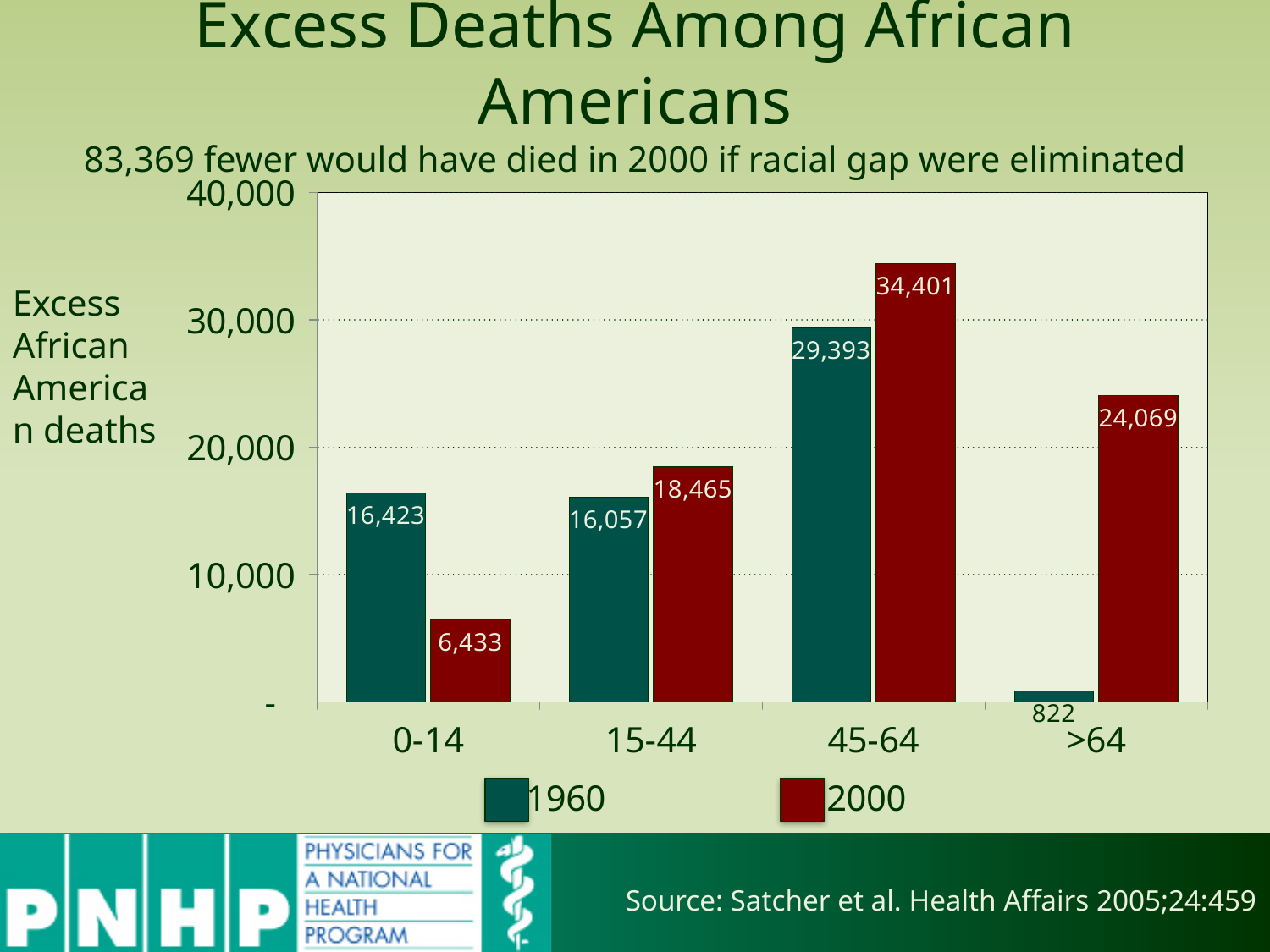
What is the difference between the 2000 and 1960 values in the 45-64 age group? 5,008 What is the value for the 1960 series in the 0-14 age group? 16,423 What is the value for the 2000 series in the 0-14 age group? 6,433 How many age groups are shown on the x axis? 4 What is the value for the 2000 series in the 45-64 age group? 34,401 How many series does the legend list? 2 Which age group has the lowest value for the 1960 series? >64 What kind of chart is shown on the slide? Bar chart What is the value for the 1960 series in the >64 age group? 822 Which age group has the highest value for the 2000 series? 45-64 What is the title of the chart? Excess Deaths Among African Americans In the 0-14 age group, which series has the larger value, 1960 or 2000? 1960